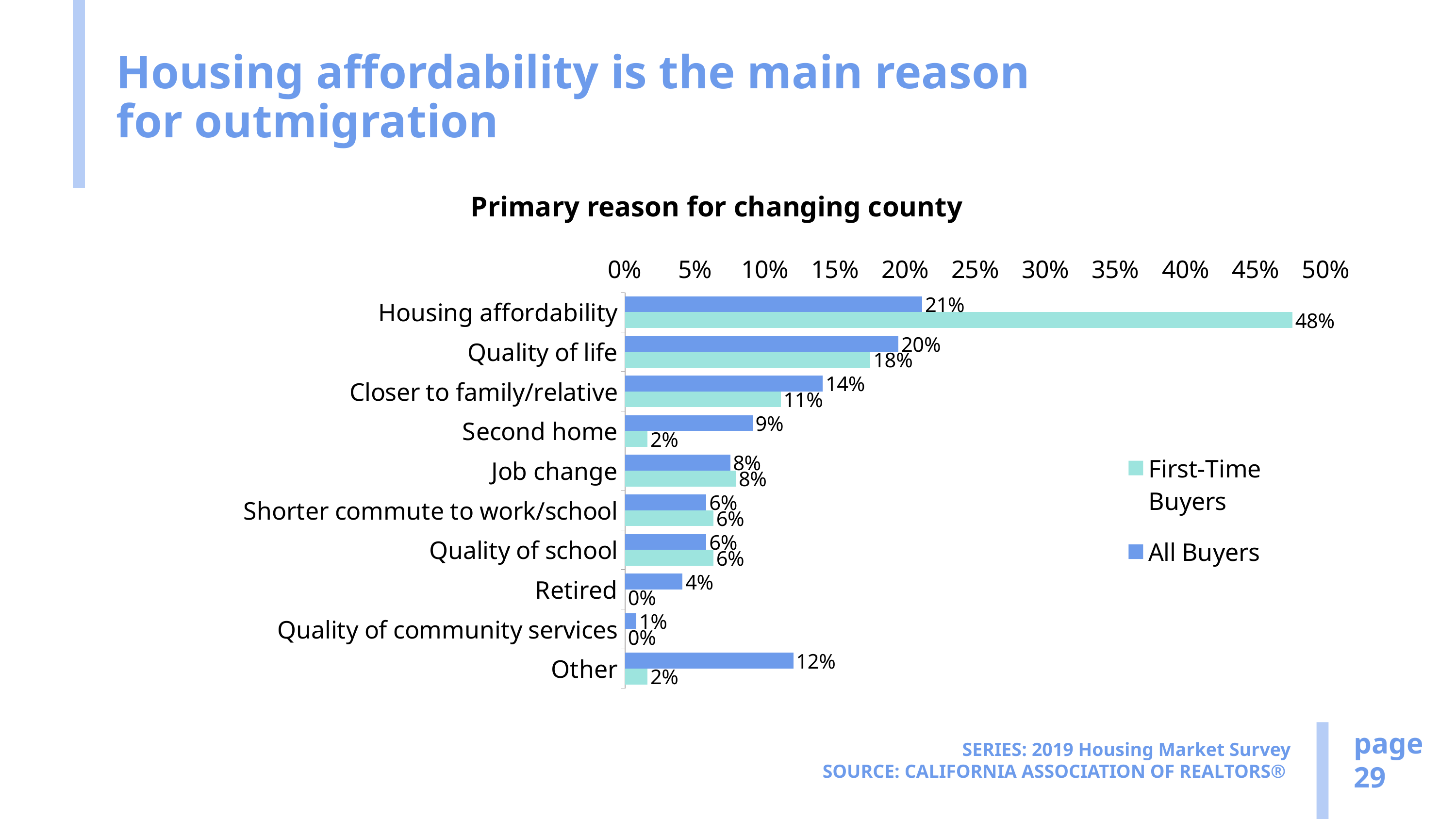
How many series does the legend list? 2 What kind of chart is shown on the slide? Bar chart What is the difference between the First-Time Buyers and All Buyers values for Housing affordability? 27% What percentage of First-Time Buyers cited Housing affordability as their primary reason for changing county? 48% What is the difference between the All Buyers and First-Time Buyers values for Second home? 7% Which category has the lowest value for All Buyers? Quality of community services What is the value for All Buyers for the Other category? 12% Which category has the highest value for First-Time Buyers? Housing affordability What is the title of the chart? Primary reason for changing county How many categories are shown on the chart? 10 For Closer to family/relative, which series has the larger value, All Buyers or First-Time Buyers? All Buyers What percentage of All Buyers cited Quality of life as their primary reason for changing county? 20%